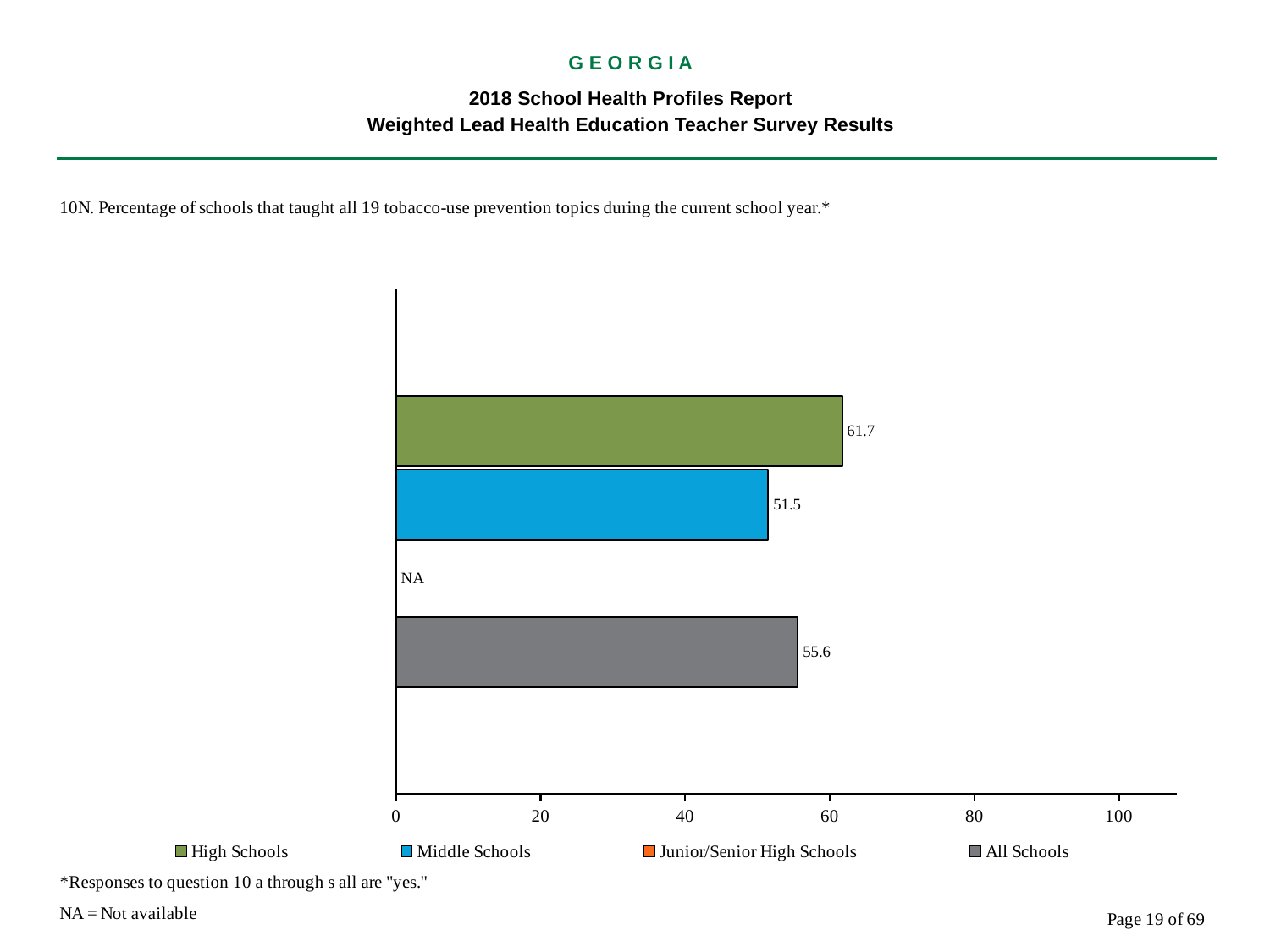
What is shown for Junior/Senior High Schools? NA What is the value for Middle Schools? 51.5 What is the value for All Schools? 55.6 What kind of chart is shown? Bar chart What colour is the bar for Middle Schools? Blue Which school type with a plotted value has the lowest value? Middle Schools What is the value for High Schools? 61.7 How many series does the legend list? 4 Which school type has the highest value? High Schools Is the value for High Schools greater or less than 60? greater Which is larger, the value for All Schools or the value for Middle Schools? All Schools What is the difference between the High Schools and Middle Schools values? 10.2